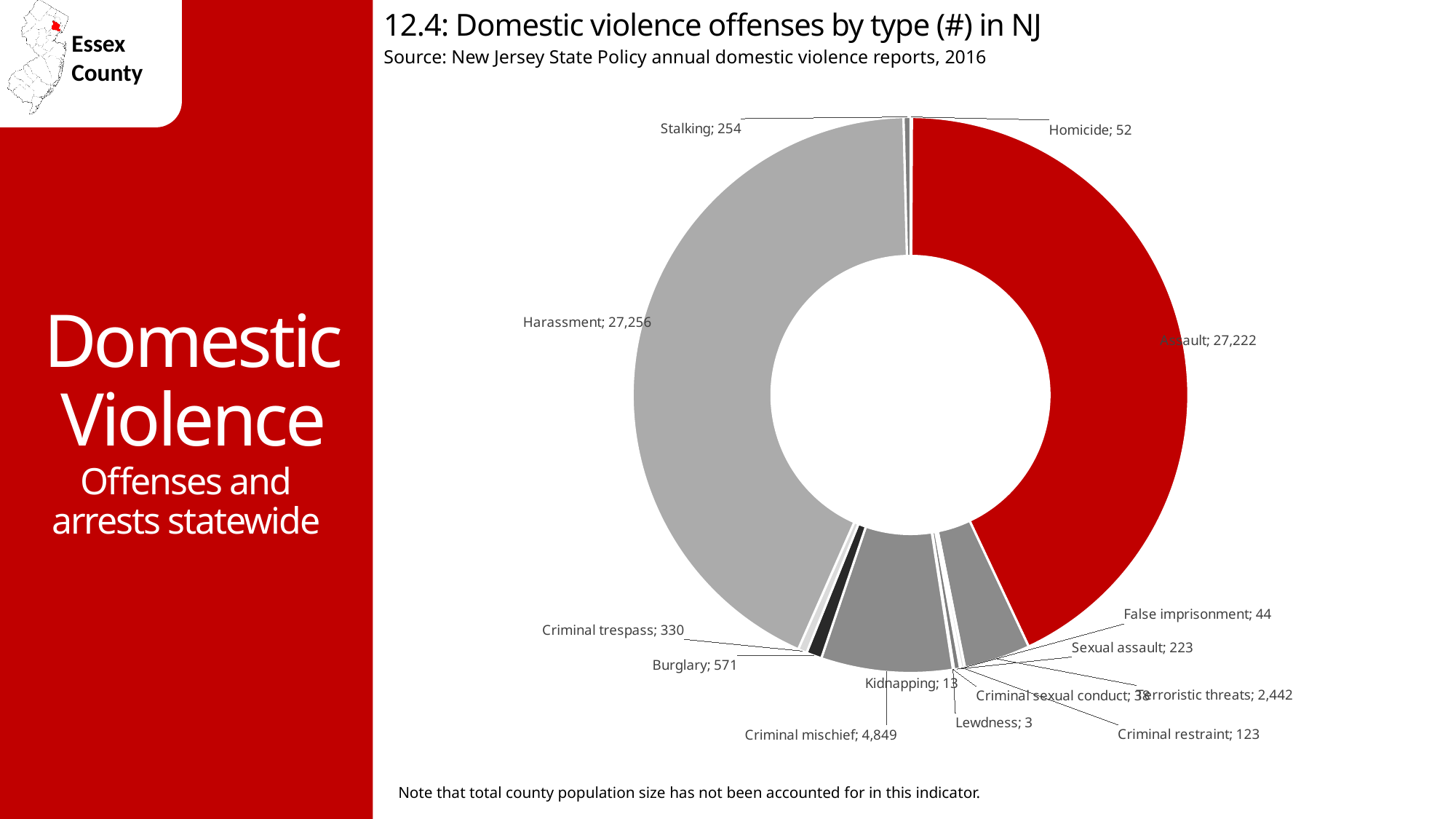
What is the value for Criminal mischief? 4,849 What is the difference between Criminal mischief and Terroristic threats? 2,407 What kind of chart is shown on the slide? doughnut chart What is the difference between Burglary and Criminal trespass? 241 Which is larger, Harassment or Assault? Harassment How many offense types are shown in the chart? 14 Which offense type has the lowest value in the chart? Lewdness What is the value for Terroristic threats? 2,442 What is the number of Assault offenses shown in the chart? 27,222 What is the value for Homicide? 52 What is the title of the chart? 12.4: Domestic violence offenses by type (#) in NJ What is the number of Harassment offenses shown in the chart? 27,256